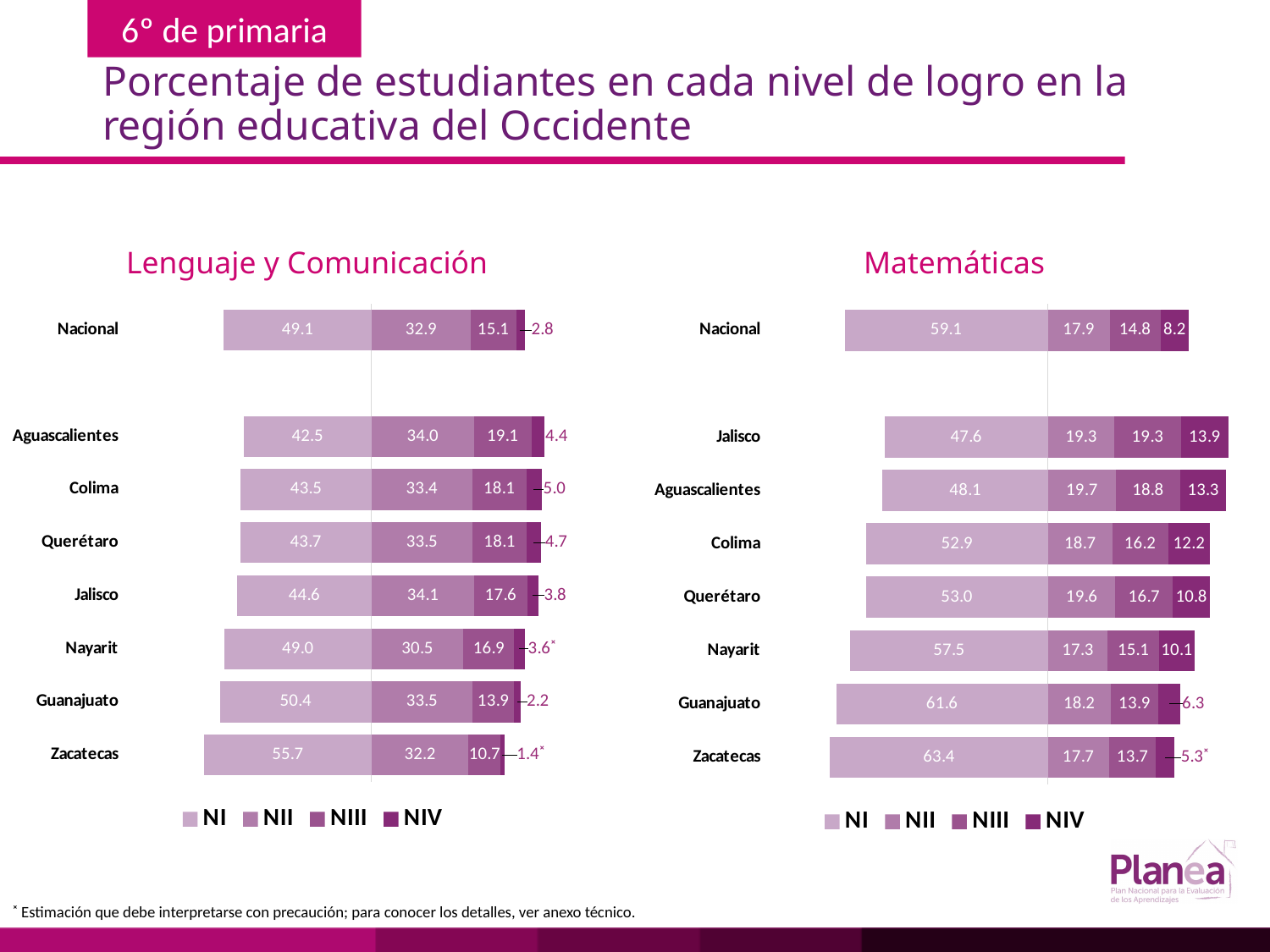
In the Lenguaje y Comunicación chart, what is the NI value for Zacatecas? 55.7 In the Lenguaje y Comunicación chart, what is the NIV value for Colima? 5.0 In the Lenguaje y Comunicación chart, which category has the highest NI value? Zacatecas How many categories are shown in the Matemáticas chart? 8 In the Matemáticas chart, what is the total of the stacked bar for Nacional? 100.0 What kind of chart is the Matemáticas chart? Stacked bar chart In the Matemáticas chart, which category has the lowest NIV value? Zacatecas What are the legend entries of the Lenguaje y Comunicación chart? NI, NII, NIII, NIV In the Matemáticas chart, what is the difference between the NI value for Zacatecas and the NI value for Jalisco? 15.8 In the Lenguaje y Comunicación chart, which has the larger NIII value, Aguascalientes or Guanajuato? Aguascalientes In the Matemáticas chart, what is the NIV value for Jalisco? 13.9 How many series does the legend of the Lenguaje y Comunicación chart list? 4